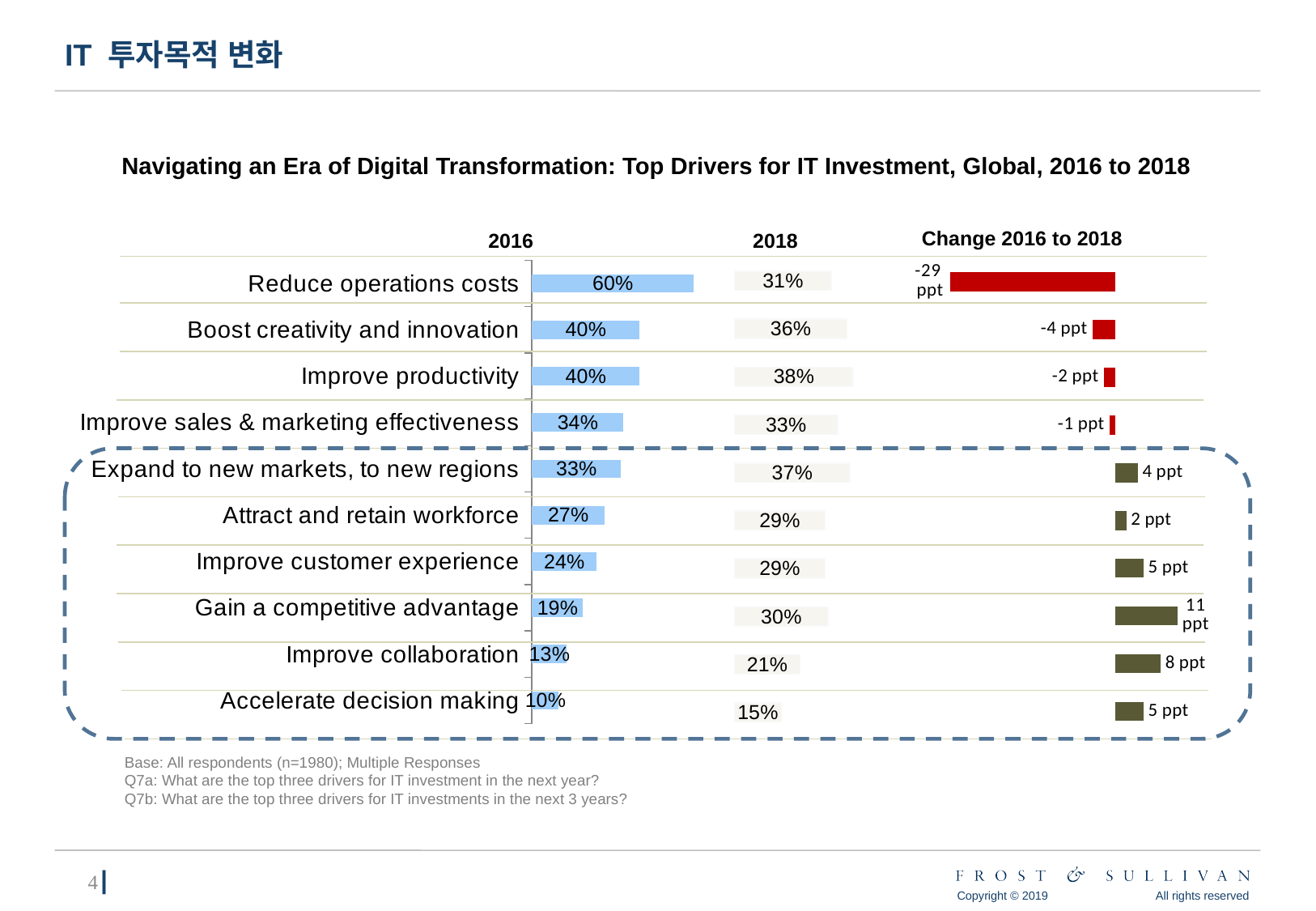
Which driver shows the largest positive change from 2016 to 2018? Gain a competitive advantage Which driver shows the largest decrease from 2016 to 2018? Reduce operations costs How many IT investment drivers are listed in the chart? 10 What kind of chart is used to show the 2016 values? Bar chart In 2018, which is larger: Improve productivity or Boost creativity and innovation? Improve productivity Which driver has the lowest value in 2018? Accelerate decision making What is the difference between the 2016 values for Reduce operations costs and Boost creativity and innovation? 20 percentage points What is the change from 2016 to 2018 for Improve collaboration? 8 ppt What is the title of the chart? Navigating an Era of Digital Transformation: Top Drivers for IT Investment, Global, 2016 to 2018 What is the 2016 value for Reduce operations costs? 60% What is the 2018 value for Gain a competitive advantage? 30% Which driver has the highest value in 2016? Reduce operations costs